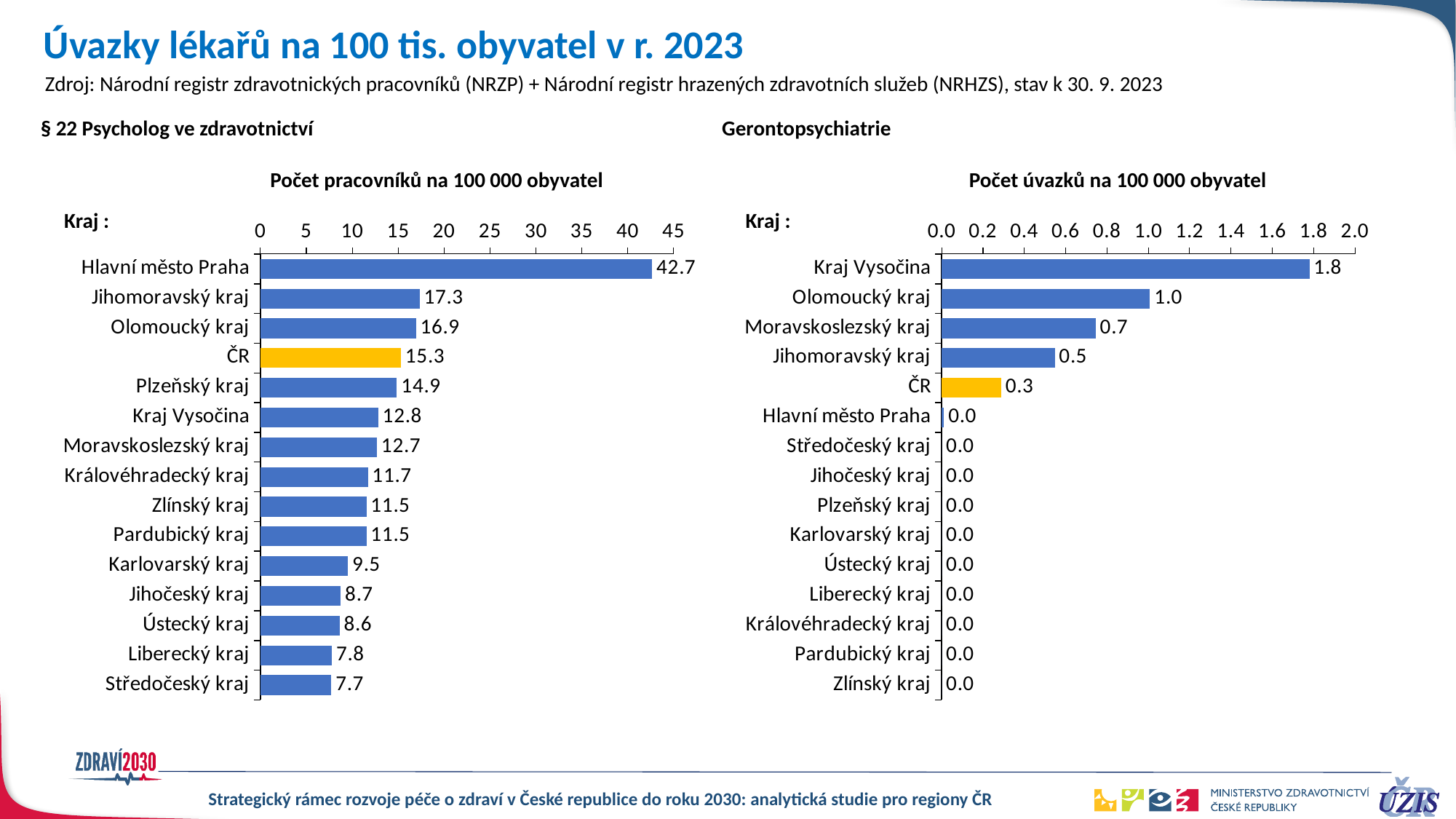
In the right chart (Gerontopsychiatrie), what is the value for ČR? 0.3 In the right chart (Gerontopsychiatrie), what is the value for Kraj Vysočina? 1.8 In the left chart (§ 22 Psycholog ve zdravotnictví), what is the value for Hlavní město Praha? 42.7 In the right chart (Gerontopsychiatrie), what is the difference between Olomoucký kraj and Moravskoslezský kraj? 0.3 What type of chart is the right chart (Gerontopsychiatrie)? Bar chart In the left chart (§ 22 Psycholog ve zdravotnictví), which is larger, Plzeňský kraj or Kraj Vysočina? Plzeňský kraj In the left chart (§ 22 Psycholog ve zdravotnictví), what is the difference between Hlavní město Praha and Jihomoravský kraj? 25.4 In the left chart (§ 22 Psycholog ve zdravotnictví), which region has the lowest value? Středočeský kraj In the left chart (§ 22 Psycholog ve zdravotnictví), what is the value for ČR? 15.3 In the right chart (Gerontopsychiatrie), which region has the highest value? Kraj Vysočina What is the axis title of the right chart (Gerontopsychiatrie)? Počet úvazků na 100 000 obyvatel In the left chart (§ 22 Psycholog ve zdravotnictví), how many categories (bars) are shown? 15